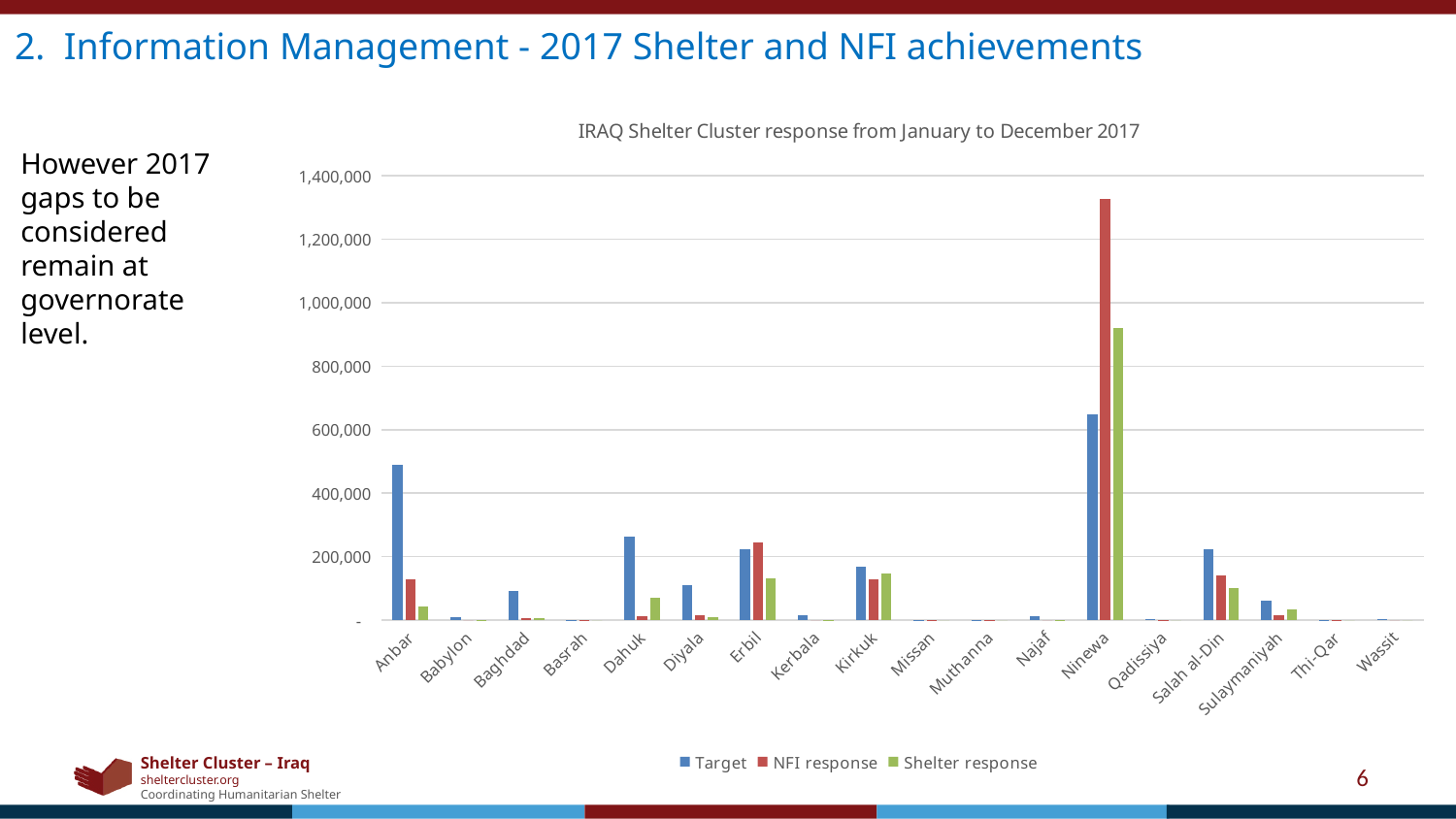
Which governorate has the highest Target value? Ninewa Is the NFI response value for Ninewa greater or less than 1,200,000? greater Which is larger, the Target value for Anbar or the Target value for Dahuk? Anbar What kind of chart is shown on the slide? Bar chart Which governorate has the highest NFI response value? Ninewa What is the title of the chart? IRAQ Shelter Cluster response from January to December 2017 Which is larger for Anbar, the NFI response or the Shelter response? NFI response Is the Target value for Anbar greater or less than 400,000? greater How many governorates are shown on the x axis of the chart? 18 Is the Target value for Kirkuk greater or less than 200,000? less How many series does the chart legend list? 3